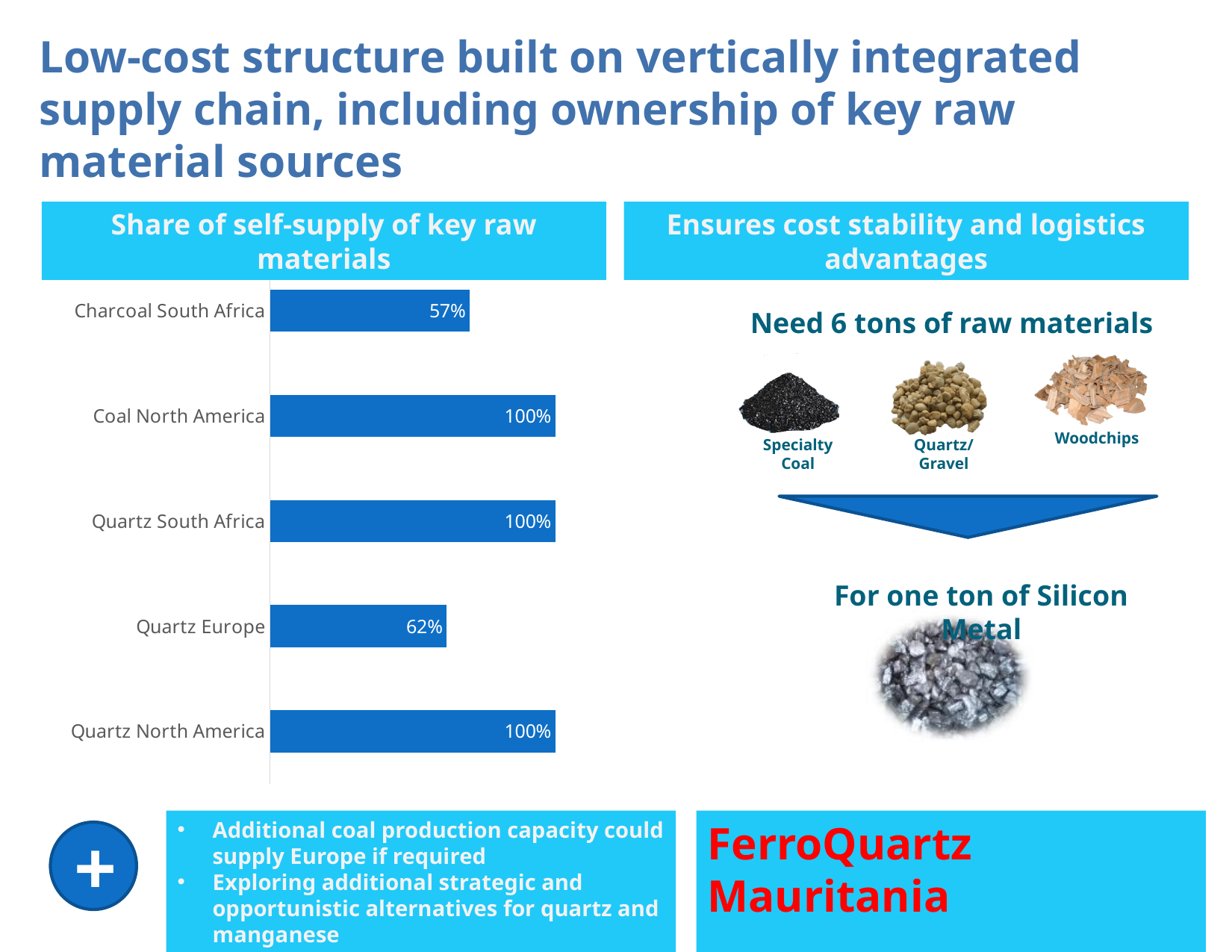
What is the difference between the self-supply share of Quartz Europe and Charcoal South Africa? 5% What is the difference between the self-supply share of Quartz South Africa and Quartz Europe? 38% What is the share of self-supply for Charcoal South Africa? 57% What is the share of self-supply for Quartz North America? 100% What is the share of self-supply for Quartz Europe? 62% What type of chart is used to show the share of self-supply of key raw materials? Bar chart What is the share of self-supply for Coal North America? 100% Which has a higher share of self-supply, Quartz Europe or Charcoal South Africa? Quartz Europe How many categories in the chart have a self-supply share of 100%? 3 Which category has the lowest share of self-supply? Charcoal South Africa How many categories are shown in the bar chart? 5 What is the title of the chart on the left side of the slide? Share of self-supply of key raw materials